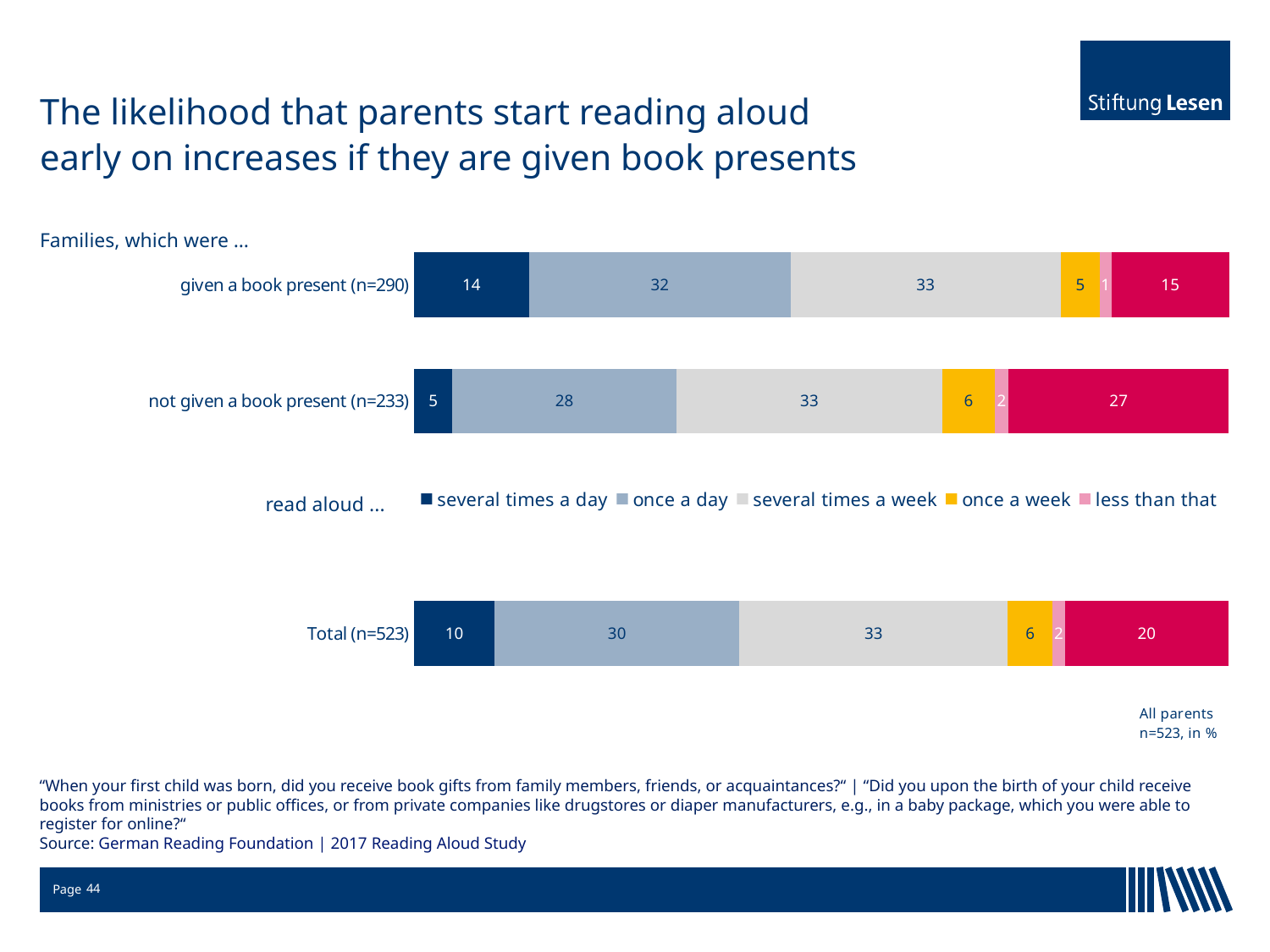
Which group has the highest value for 'several times a day'? given a book present (n=290) What is the difference between the 'several times a day' values for families given a book present and those not given a book present? 9 What is the total of the labelled segments in the 'given a book present (n=290)' bar? 100 What is the 'once a week' value for families given a book present? 5 How many series does the legend list? 5 What percentage of families given a book present read aloud several times a day? 14 What is the 'several times a week' value for the Total (n=523) bar? 33 What kind of chart is shown on the slide? stacked bar chart Which group has the lowest value for 'once a day'? not given a book present (n=233) Is the 'once a day' value larger for families given a book present or for families not given a book present? given a book present What is the value for 'once a day' in the 'not given a book present (n=233)' bar? 28 How many bars (groups) are shown in the chart? 3